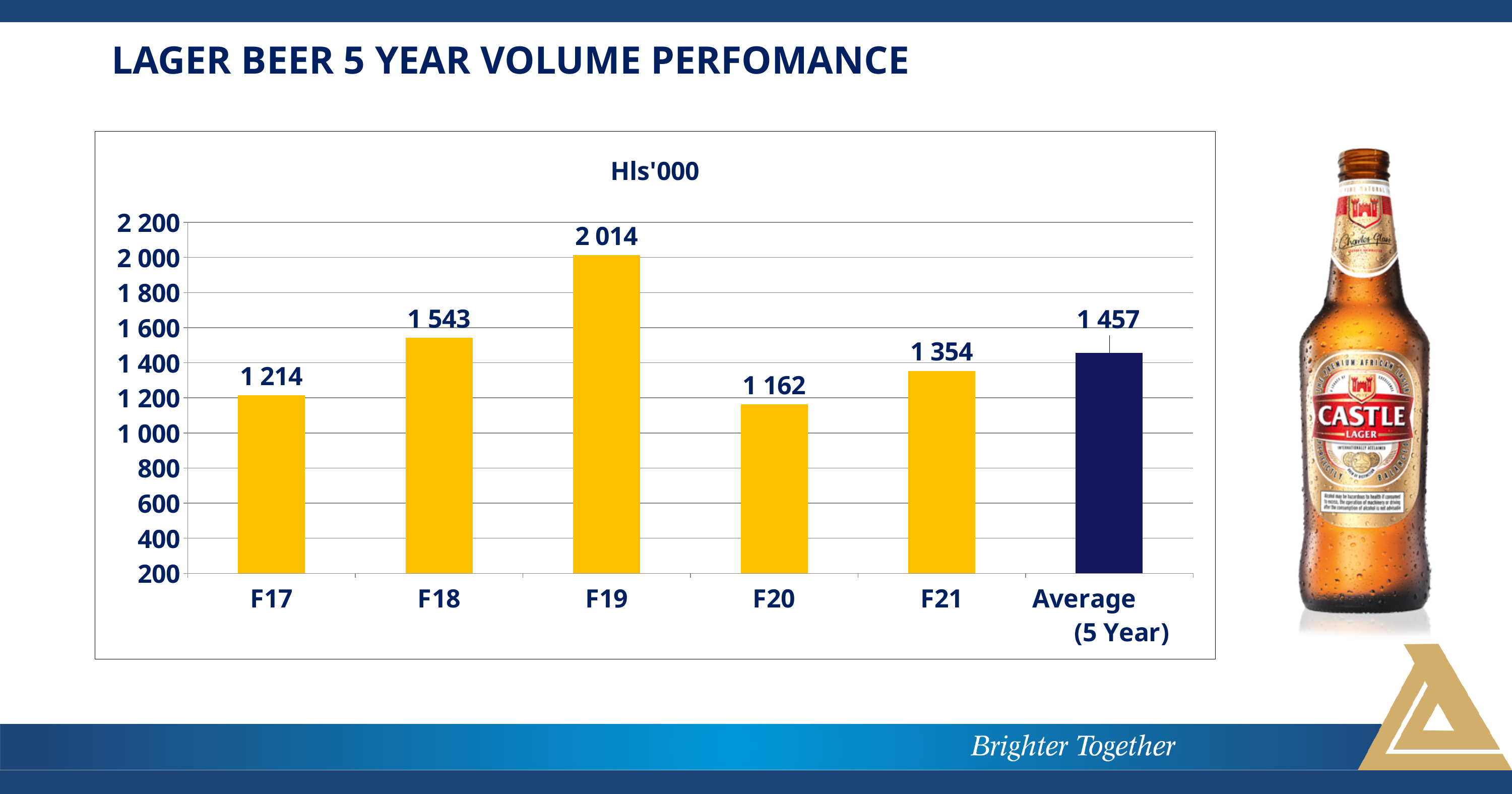
Does the value rise or fall from F19 to F20? Fall How many bars are plotted on the chart? 6 Which category has the lowest value? F20 What kind of chart is shown on the slide? Bar chart What is the value for F19? 2 014 What is the difference between the values for F21 and F20? 192 Which is larger, the value for F18 or the value for F21? F18 What is the value for F17? 1 214 What is the difference between the values for F19 and F20? 852 What unit label is shown above the chart? Hls'000 Which category has the highest value? F19 What is the value for the Average (5 Year) bar? 1 457